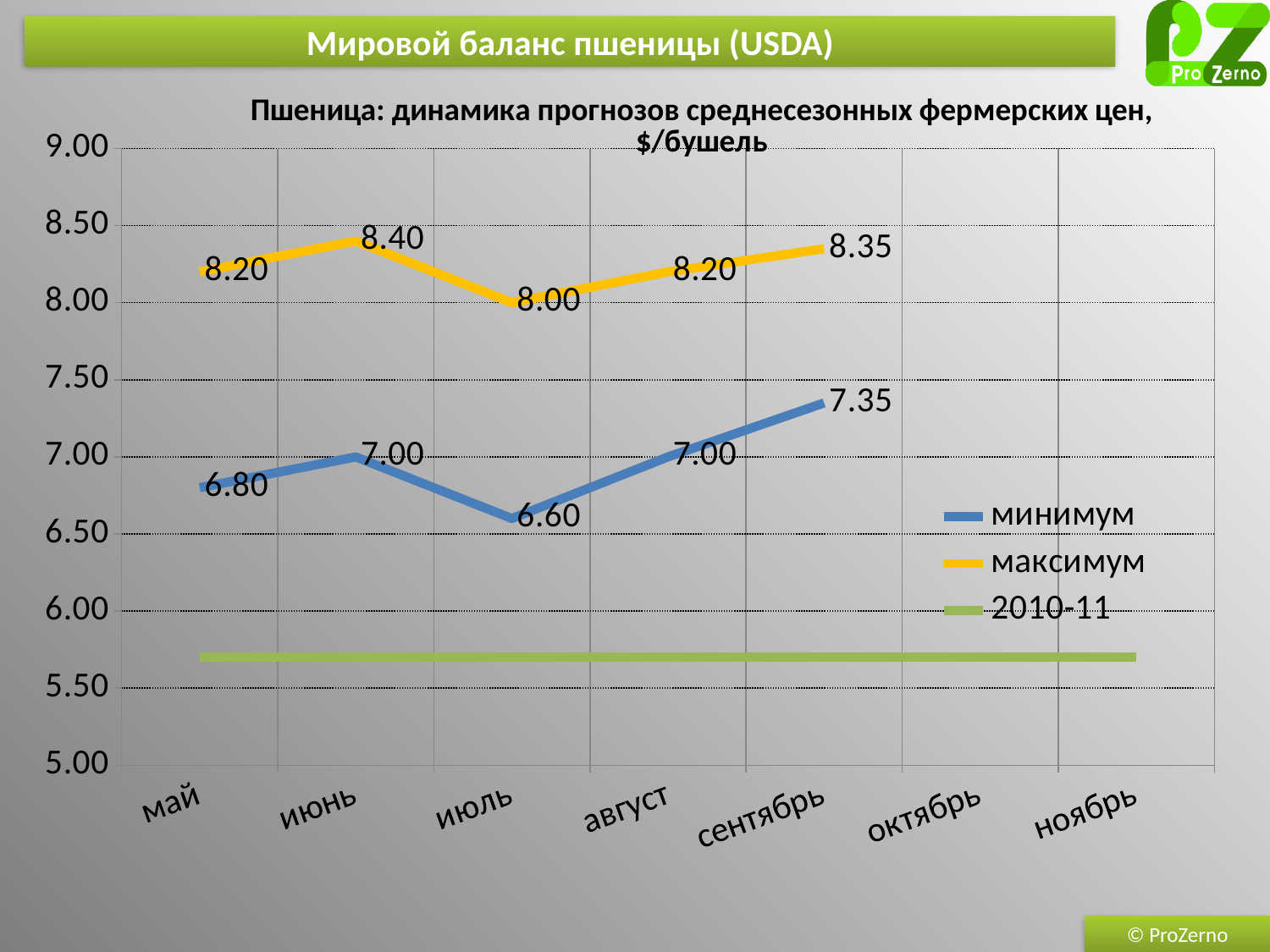
Does the минимум series rise or fall from июль to сентябрь? rise What kind of chart is shown on the slide? line chart How many series does the legend list? 3 How many months are shown on the x axis? 7 What is the value of the максимум series in сентябрь? 8.35 Is the value of the 2010-11 line greater or less than 6.00? less In which month does the максимум series reach its highest value? июнь What is the difference between the максимум and минимум values in сентябрь? 1.00 What is the value of the минимум series in июль? 6.60 What is the value of the максимум series in июнь? 8.40 Which is larger: the минимум value in май or in сентябрь? сентябрь In which month does the минимум series reach its lowest value? июль